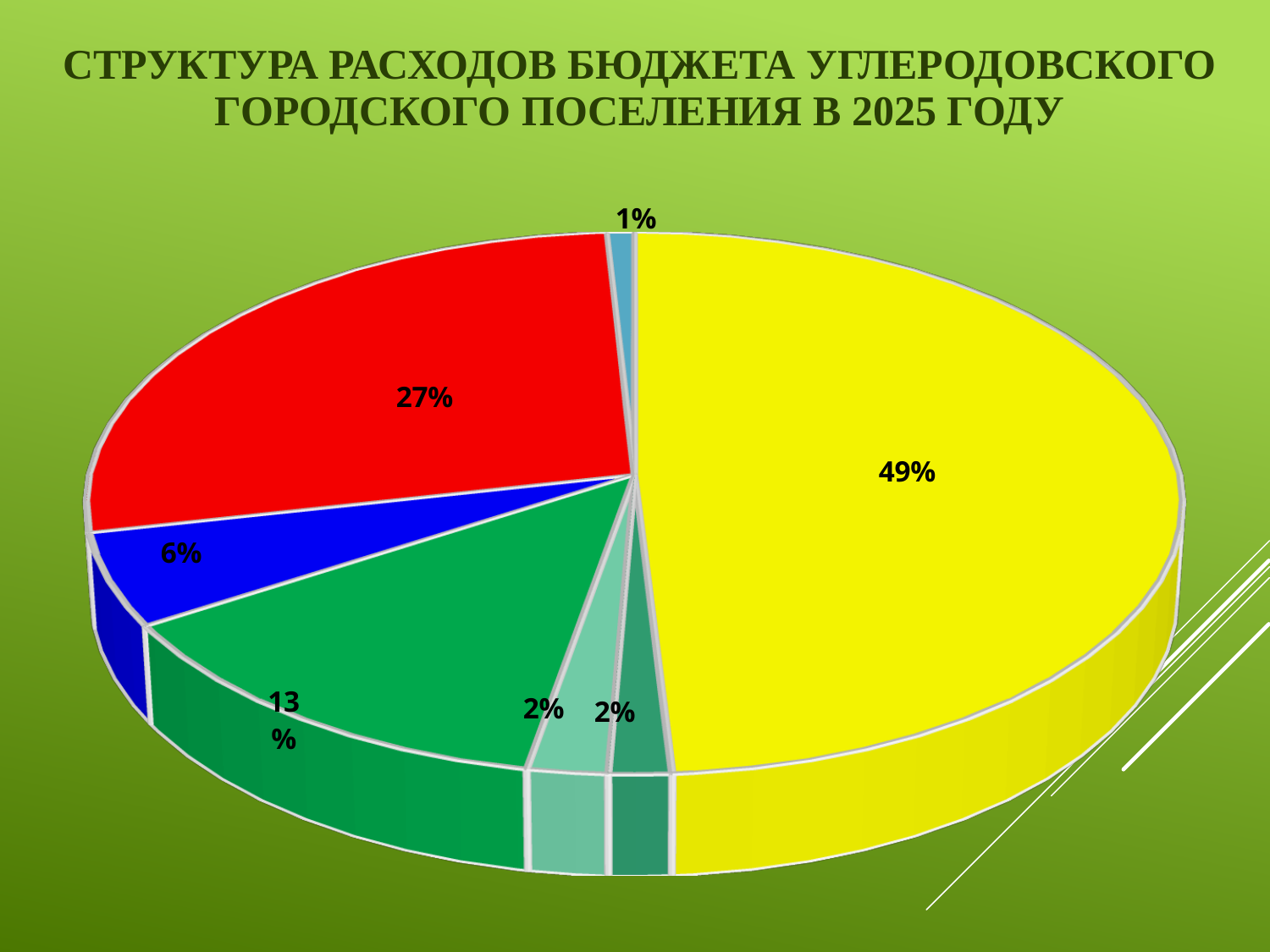
Which slice has the smallest share of the pie? The light blue slice (1%) What percentage is shown on the red slice? 27% What percentage is shown on the smallest slice, the light blue one at the top? 1% What percentage is shown on the yellow slice? 49% How many slices does the pie chart have? 7 Which slice has the largest share of the pie? The yellow slice (49%) Which is larger, the red slice or the green slice? The red slice What percentage is shown on the large green slice? 13% What kind of chart is shown on the slide? Pie chart What is the difference in percentage points between the yellow slice and the red slice? 22 percentage points What percentage is shown on the blue slice? 6% What is the title of the chart? СТРУКТУРА РАСХОДОВ БЮДЖЕТА УГЛЕРОДОВСКОГО ГОРОДСКОГО ПОСЕЛЕНИЯ В 2025 ГОДУ